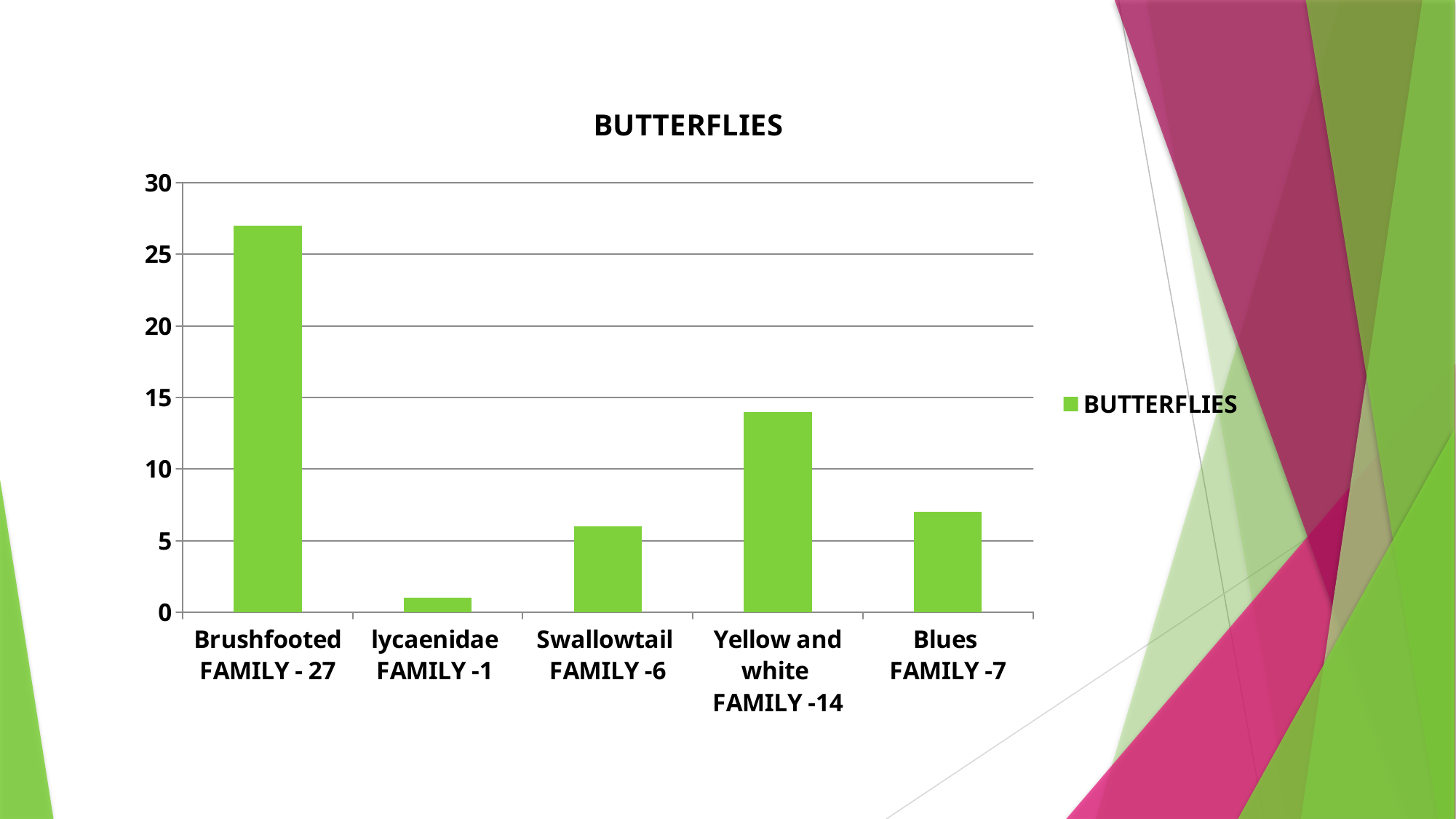
Which family has the highest value? Brushfooted FAMILY What is the title of the chart? BUTTERFLIES Which is larger, the value for the Swallowtail family or the Yellow and white family? Yellow and white FAMILY How many families are shown on the chart? 5 What is the value for the Yellow and white family? 14 Which family has the lowest value? lycaenidae FAMILY What is the difference between the Blues family and the Swallowtail family? 1 What type of chart is shown? bar chart Is the value for the Brushfooted family greater or less than 25? greater What is the value for the Brushfooted family? 27 What is the value for the Blues family? 7 What is the difference between the Brushfooted family and the Yellow and white family? 13